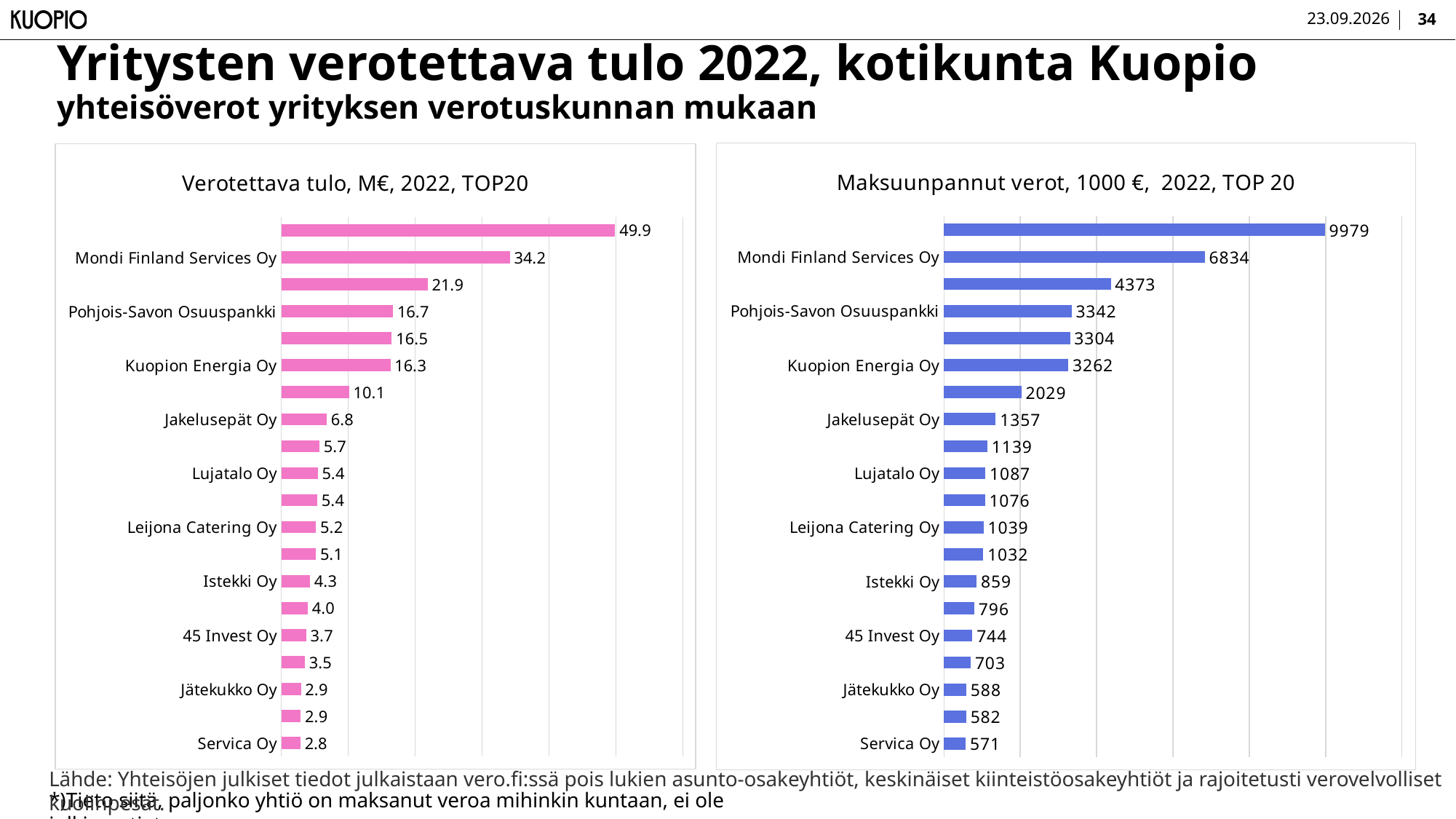
In the chart 'Verotettava tulo, M€, 2022, TOP20', what is the value for Pohjois-Savon Osuuspankki? 16.7 In the chart 'Maksuunpannut verot, 1000 €, 2022, TOP 20', what is the difference between Mondi Finland Services Oy and Pohjois-Savon Osuuspankki? 3492 In the chart 'Verotettava tulo, M€, 2022, TOP20', what is the largest value shown on any bar? 49.9 What type of chart is 'Verotettava tulo, M€, 2022, TOP20'? Bar chart In the chart 'Maksuunpannut verot, 1000 €, 2022, TOP 20', which labelled company has the lowest value? Servica Oy In the chart 'Verotettava tulo, M€, 2022, TOP20', which is larger, Lujatalo Oy or Leijona Catering Oy? Lujatalo Oy What colour are the bars in the chart 'Maksuunpannut verot, 1000 €, 2022, TOP 20'? Blue In the chart 'Verotettava tulo, M€, 2022, TOP20', what is the value for Mondi Finland Services Oy? 34.2 How many bars are shown in the chart 'Maksuunpannut verot, 1000 €, 2022, TOP 20'? 20 In the chart 'Maksuunpannut verot, 1000 €, 2022, TOP 20', what is the value for Servica Oy? 571 In the chart 'Maksuunpannut verot, 1000 €, 2022, TOP 20', what is the value for Kuopion Energia Oy? 3262 In the chart 'Verotettava tulo, M€, 2022, TOP20', what is the difference between Jakelusepät Oy and Istekki Oy? 2.5